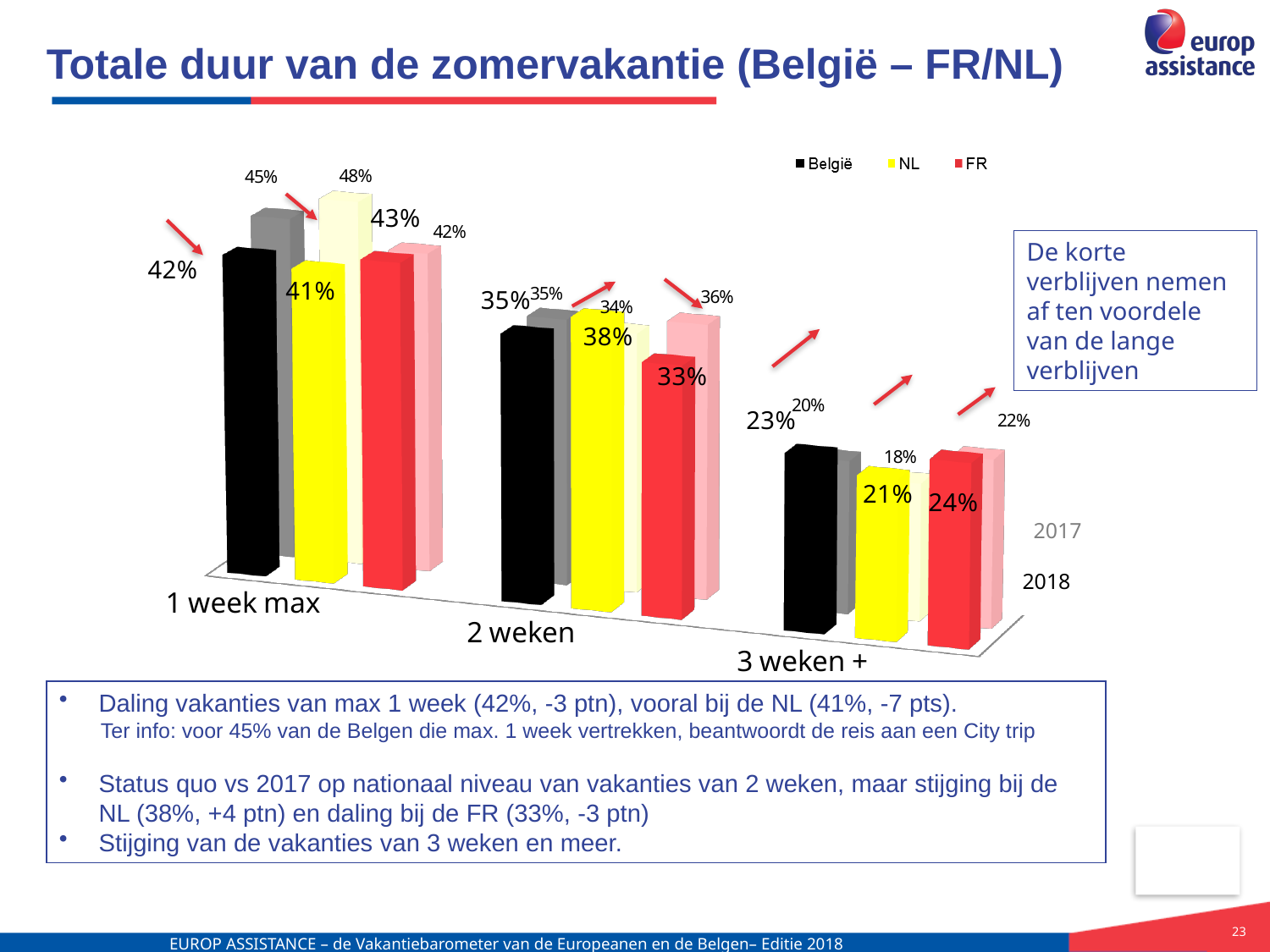
What is the difference between the 2017 and 2018 values for NL in the '1 week max' category? 7 percentage points Is the 2018 value for België in '2 weken' larger or smaller than the 2018 value for FR in '2 weken'? larger How many series does the legend list? 3 What is the 2017 value for FR in the '2 weken' category? 36% What kind of chart is shown on the slide? Bar chart Which series has the lowest 2018 value in the '3 weken +' category? NL How many duration categories are shown on the x axis? 3 What is the 2018 value for NL in the '2 weken' category? 38% What is the 2017 value for NL in the '1 week max' category? 48% Which series has the highest 2018 value in the '1 week max' category? FR What is the 2018 value for België in the '1 week max' category? 42% What is the 2018 value for FR in the '3 weken +' category? 24%